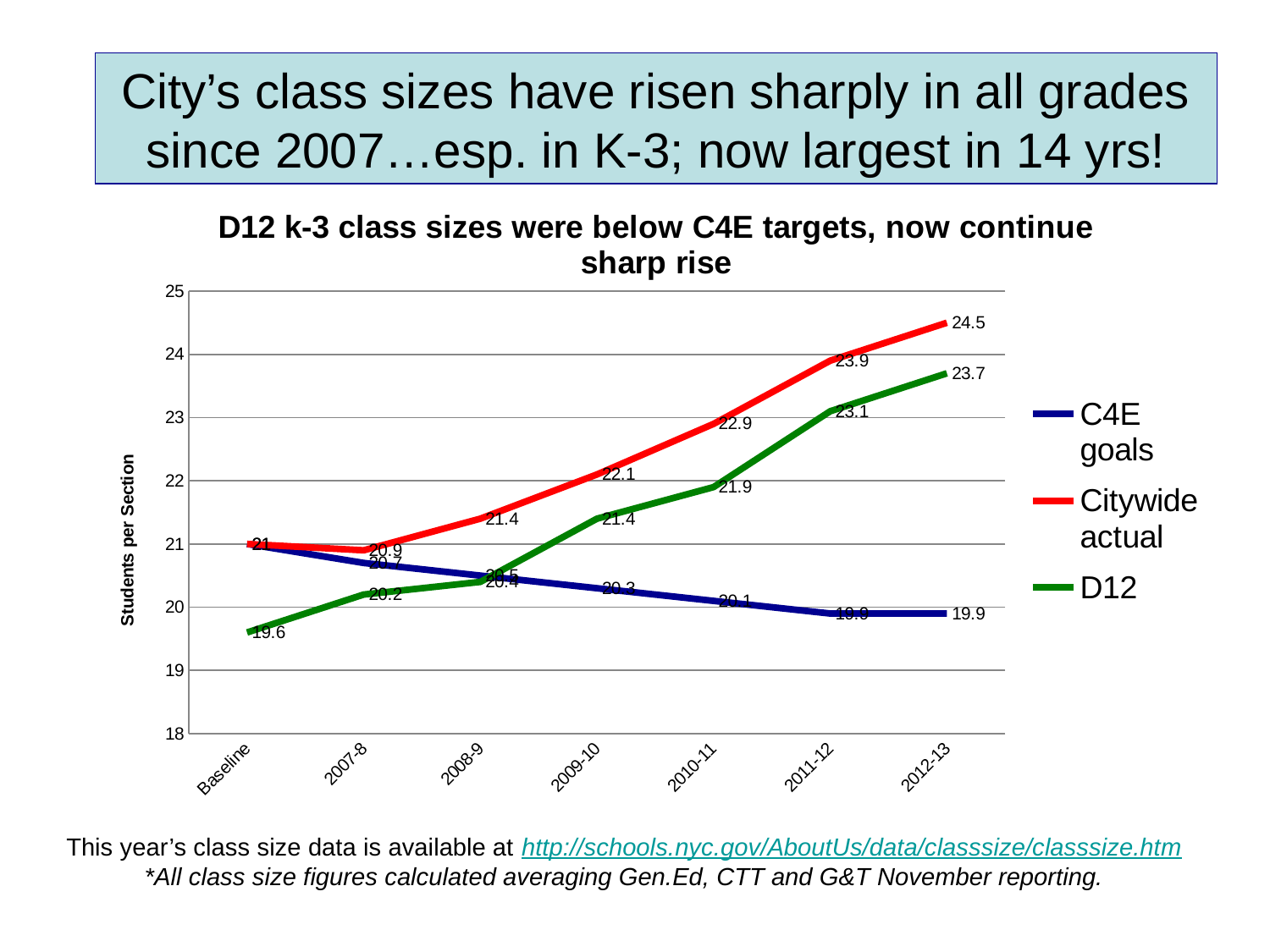
How many series does the legend list? 3 How many points are on the x axis? 7 What is the C4E goals value for 2012-13? 19.9 What kind of chart is shown? line chart Which is larger in 2010-11, Citywide actual or D12? Citywide actual What is the D12 value for 2011-12? 23.1 Which series has the highest value in 2012-13? Citywide actual At which point on the x axis is the D12 series lowest? Baseline What is the D12 value at Baseline? 19.6 What is the difference between the Citywide actual and D12 values in 2012-13? 0.8 Is the C4E goals value for 2011-12 greater or less than 21? less What is the Citywide actual value for 2012-13? 24.5